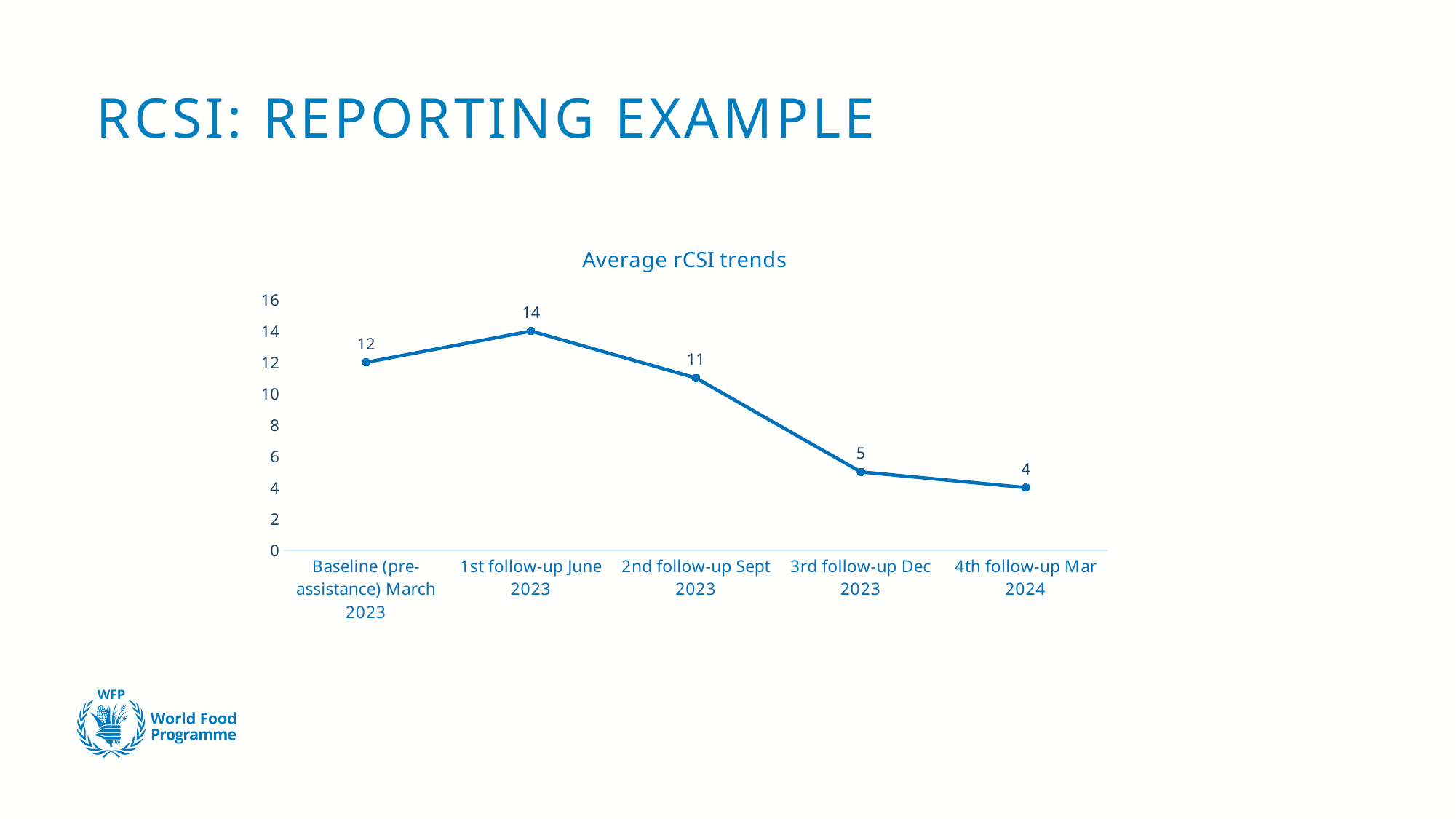
Which data point has the lowest average rCSI value? 4th follow-up Mar 2024 What is the average rCSI value at the 4th follow-up Mar 2024? 4 What is the average rCSI value at the 1st follow-up June 2023? 14 Which is larger, the average rCSI at the 2nd follow-up Sept 2023 or at the 3rd follow-up Dec 2023? 2nd follow-up Sept 2023 What kind of chart is shown on the slide? line chart What is the difference between the average rCSI at the 1st follow-up June 2023 and the 4th follow-up Mar 2024? 10 Which data point has the highest average rCSI value? 1st follow-up June 2023 From the 1st follow-up June 2023 to the 4th follow-up Mar 2024, do the average rCSI values rise or fall? fall Is the average rCSI value at the 3rd follow-up Dec 2023 greater or less than 8? less What is the average rCSI value at the Baseline (pre-assistance) March 2023? 12 How many data points are plotted on the chart? 5 What is the title of the chart? Average rCSI trends